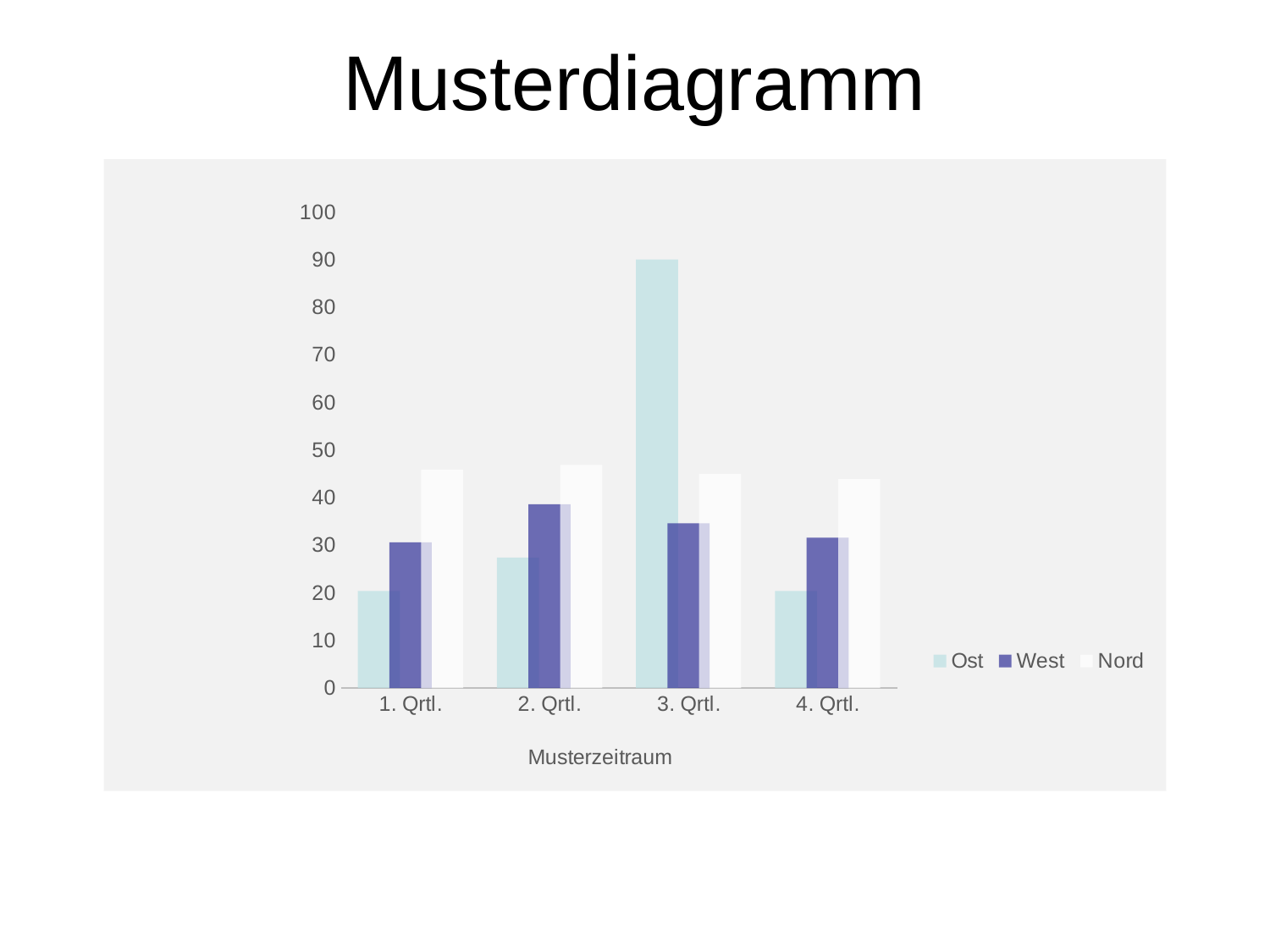
Which is larger in 3. Qrtl., the value for Ost or the value for Nord? Ost Is the value for Ost in 2. Qrtl. greater or less than 30? less In which quarter is the value for Ost lowest among 2. Qrtl. and 3. Qrtl.? 2. Qrtl. What kind of chart is shown on the slide? bar chart How many categories are shown on the x axis? 4 Is the value for Nord in 1. Qrtl. greater or less than 50? less In which quarter is the value for Ost highest? 3. Qrtl. Which is larger in 1. Qrtl., the value for Nord or the value for West? Nord Is the value for Ost in 3. Qrtl. greater or less than 80? greater What is the title of the x axis? Musterzeitraum How many series does the legend list? 3 In which quarter is the value for West highest? 2. Qrtl.